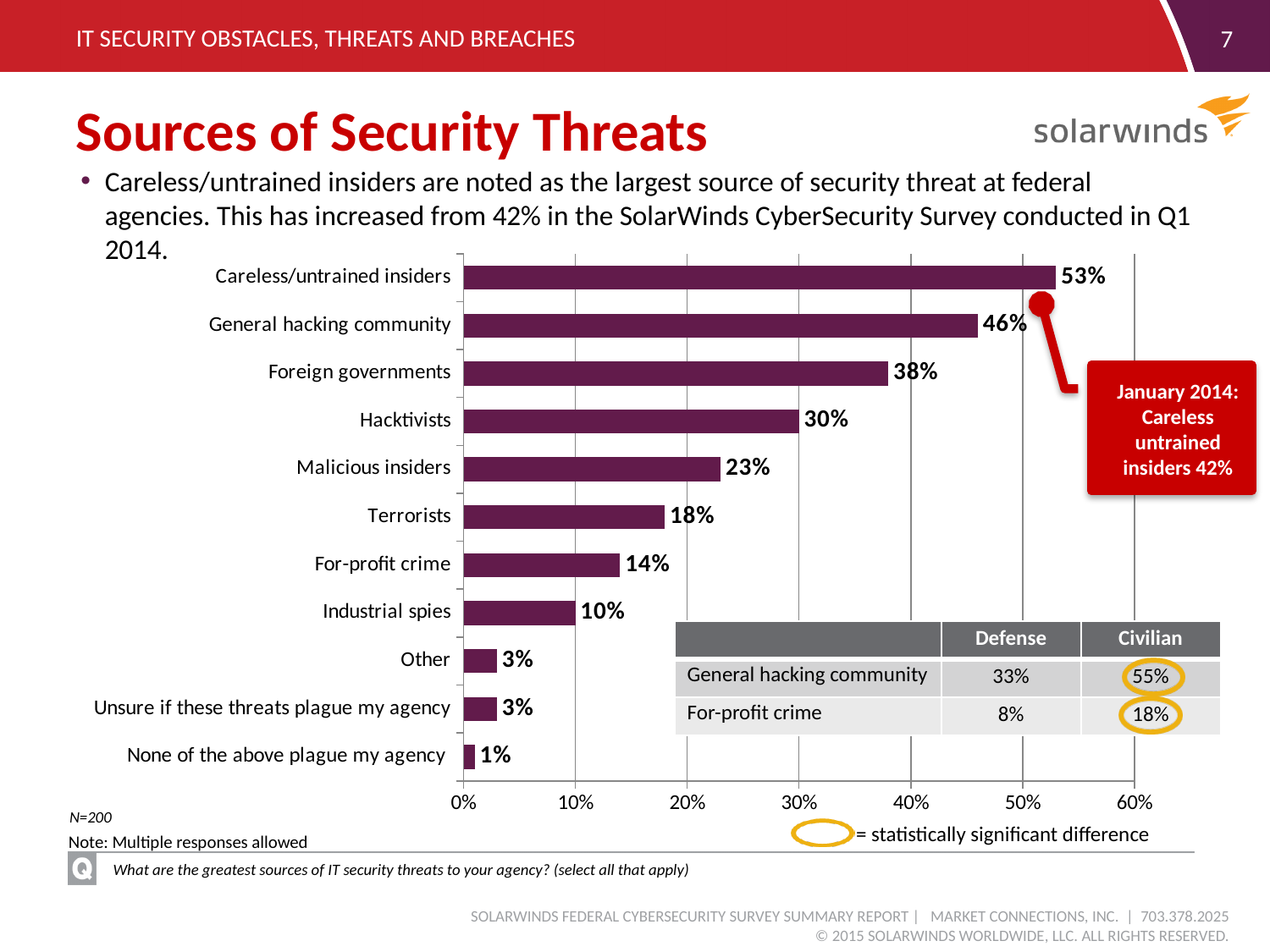
Which category has the lowest value in the chart? None of the above plague my agency How many categories are shown in the bar chart? 11 What percentage of respondents cited Careless/untrained insiders as a source of security threat? 53% What is the value shown for Malicious insiders? 23% What is the title of the slide containing the chart? Sources of Security Threats Is the value for Industrial spies greater or less than 20%? less Which category has the highest value in the chart? Careless/untrained insiders What is the value shown for Foreign governments? 38% According to the callout on the chart, what was the value for Careless untrained insiders in January 2014? 42% What is the difference between the values for General hacking community and Hacktivists? 16% What kind of chart is used to show the sources of security threats? bar chart Which is larger, the value for Terrorists or the value for For-profit crime? Terrorists